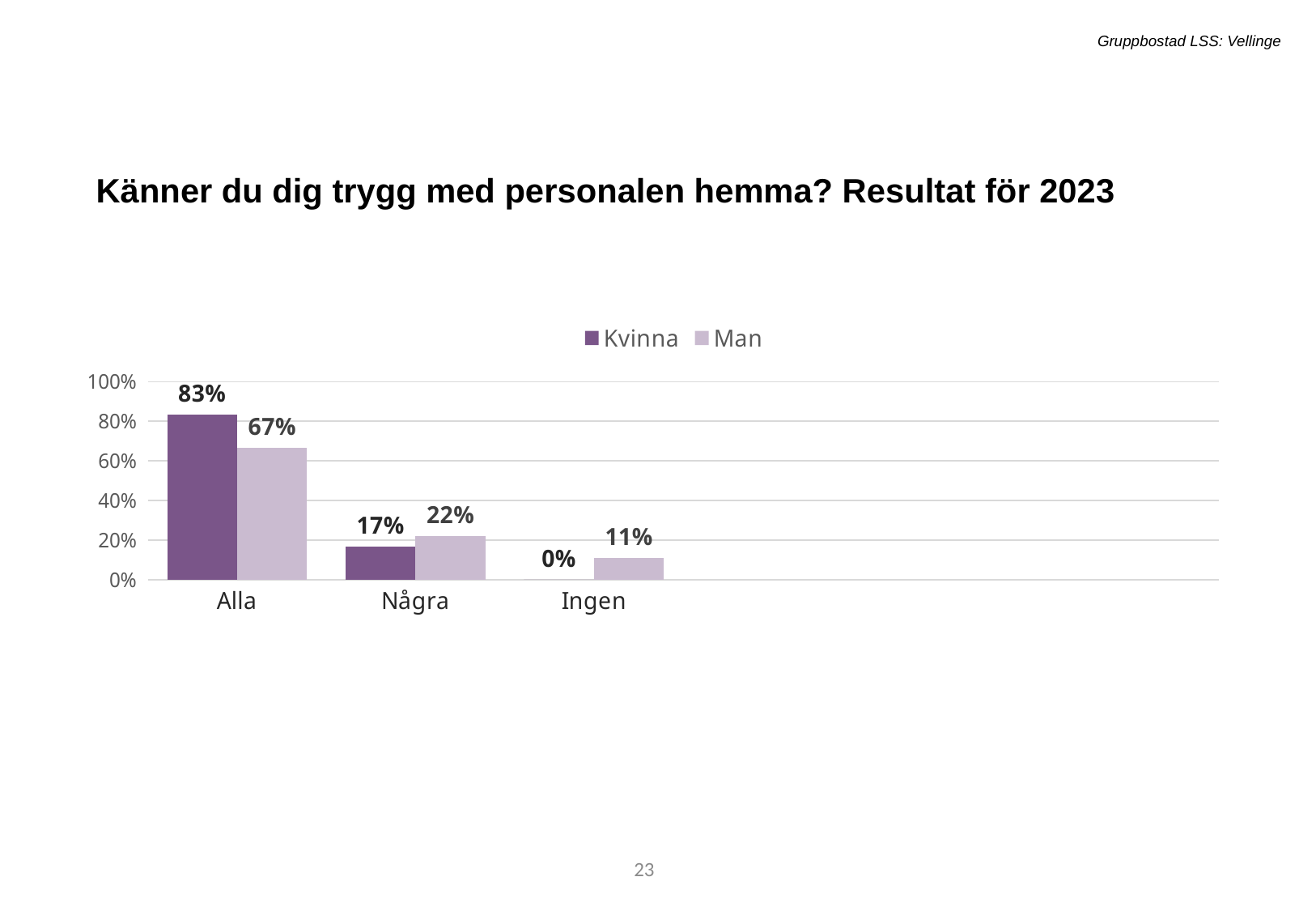
In the Några category, which series has the larger value, Kvinna or Man? Man What is the title of the chart on the slide? Känner du dig trygg med personalen hemma? Resultat för 2023 What is the value for Man in the Alla category? 67% What is the value for Kvinna in the Några category? 17% What kind of chart is shown on the slide? Bar chart How many series does the legend list? 2 Which category has the lowest value for Man? Ingen How many categories are shown on the x axis? 3 Which category has the highest value for Kvinna? Alla What is the difference between the Kvinna and Man values in the Alla category? 16% What is the value for Man in the Ingen category? 11% What is the value for Kvinna in the Alla category? 83%